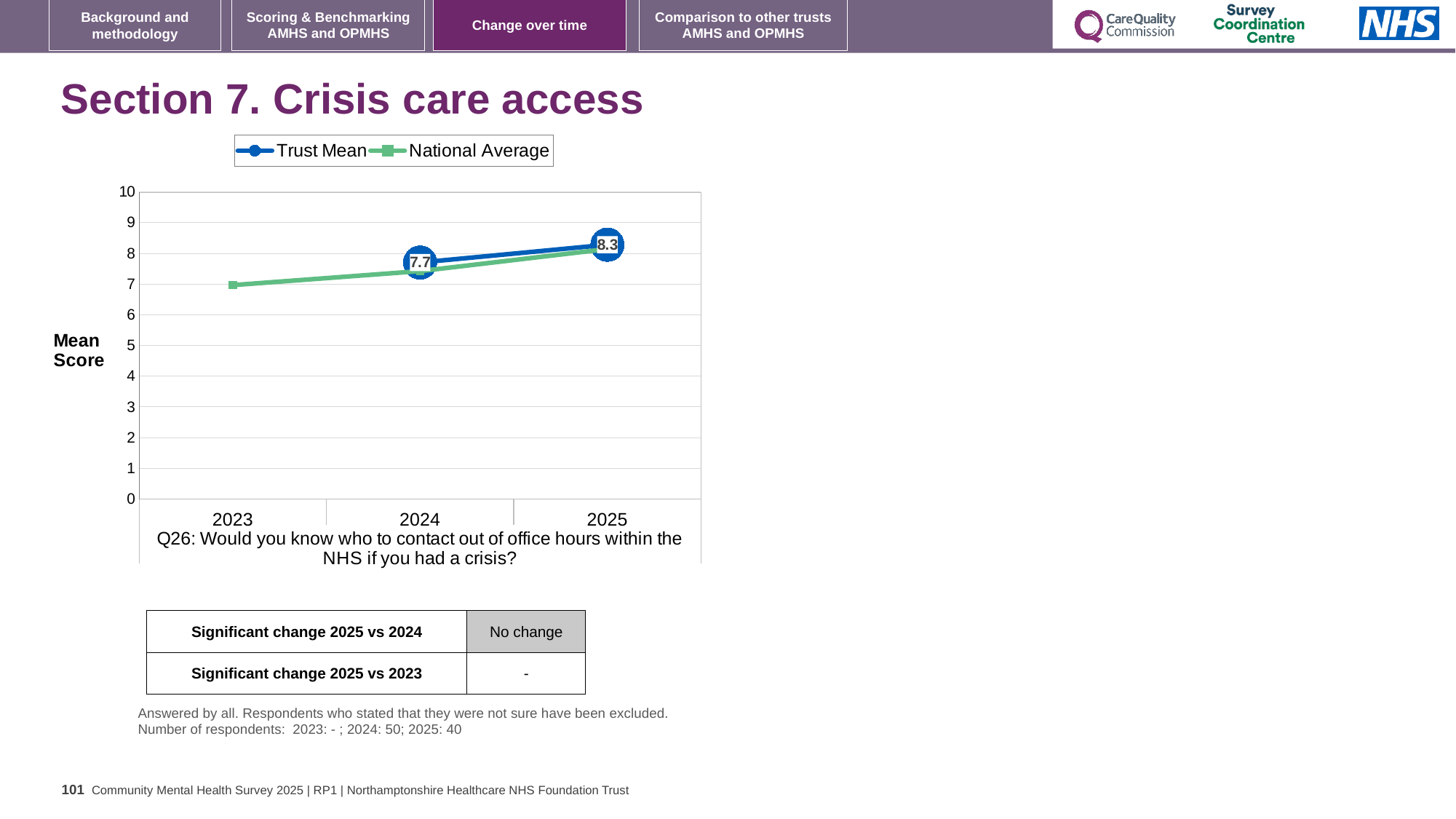
What is the Trust Mean value for 2024? 7.7 What is the label on the y axis of the chart? Mean Score What is the Trust Mean value for 2025? 8.3 Does the National Average rise or fall from 2023 to 2025? rise How many years are shown on the x axis? 3 By how much did the Trust Mean change from 2024 to 2025? 0.6 Which year has the higher Trust Mean, 2024 or 2025? 2025 Is the National Average value for 2025 greater or less than 7? greater Is the National Average value for 2023 greater or less than 8? less How many series does the legend list? 2 In which year is the Trust Mean highest? 2025 What kind of chart is shown on the slide? line chart